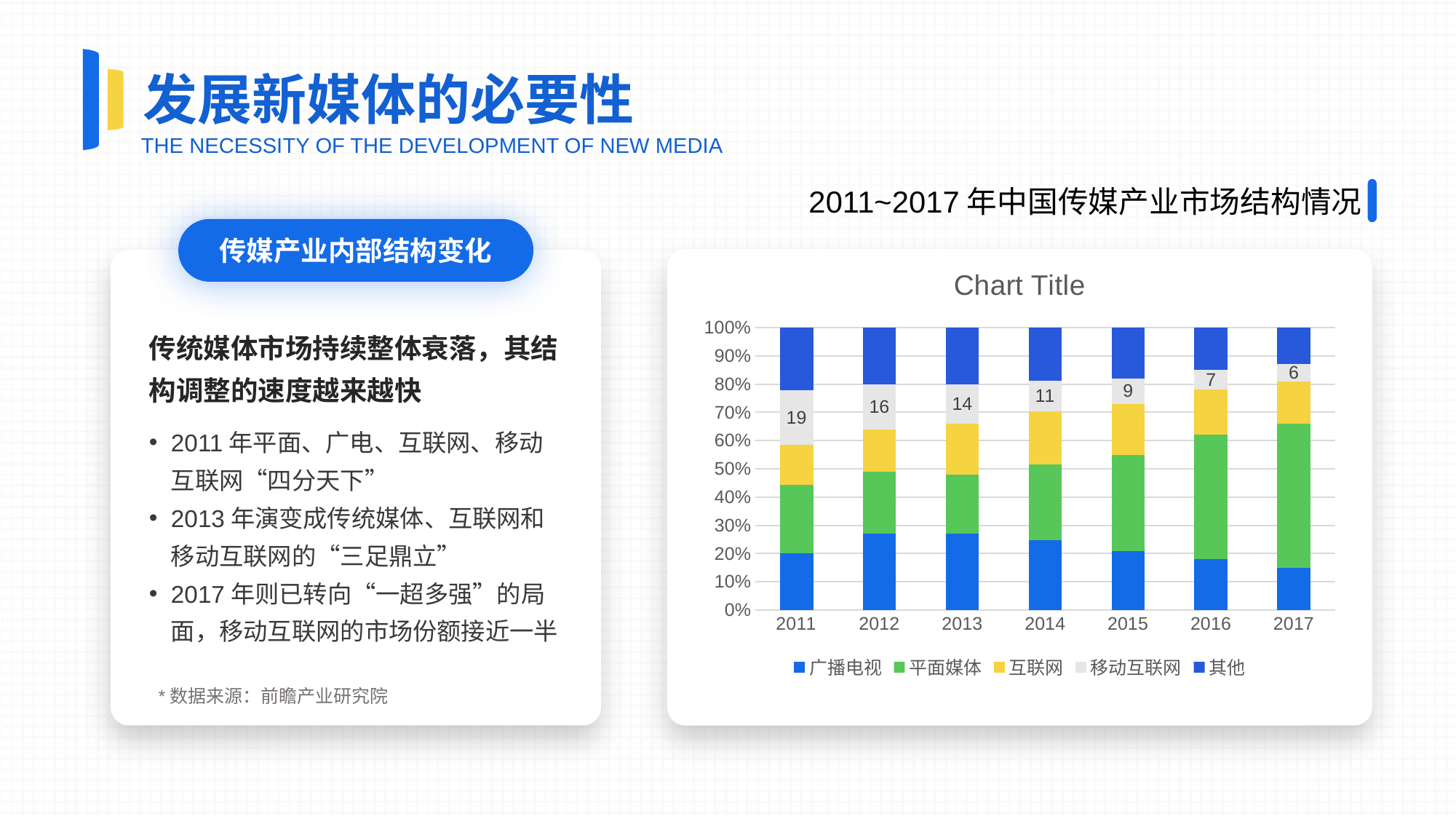
In which year is the labelled 移动互联网 value the lowest? 2017 Is the 广播电视 share in 2012 greater or less than 20%? greater What is the difference between the 移动互联网 labels for 2011 and 2017? 13 What is the data label for 移动互联网 in 2011? 19 What kind of chart is shown? stacked bar chart What is the data label for 移动互联网 in 2017? 6 In which year is the labelled 移动互联网 value the highest? 2011 Do the 移动互联网 labels rise or fall from 2011 to 2017? fall What is the data label for 移动互联网 in 2014? 11 Which year has the larger 移动互联网 label, 2012 or 2015? 2012 How many years are shown on the x axis? 7 How many series does the legend list? 5